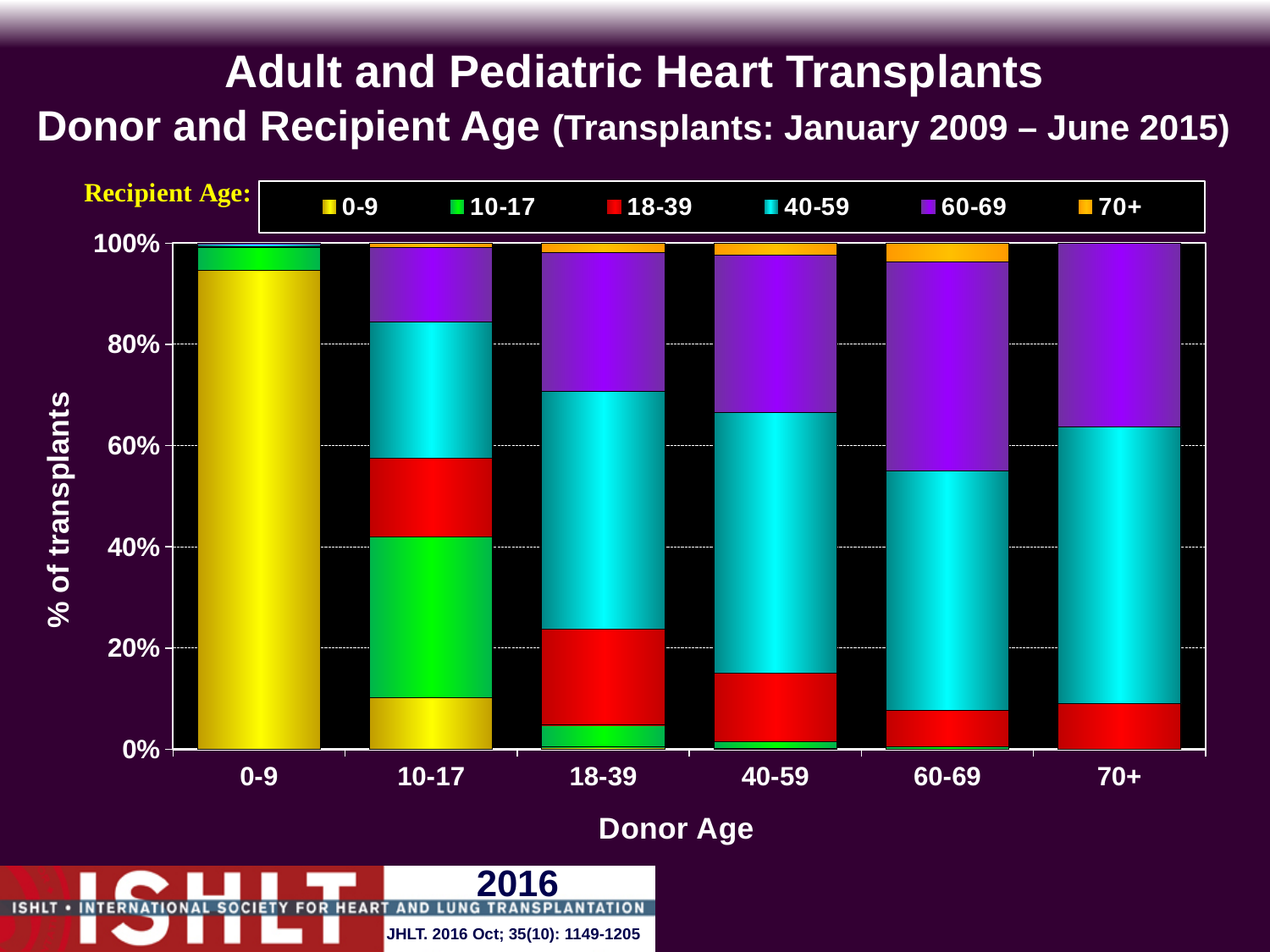
What kind of chart is shown on the slide? Stacked bar chart Does the share of 0-9 recipients rise or fall as donor age increases along the x axis? Falls For donor age 70+, which recipient age group has the larger share: 40-59 or 60-69? 40-59 How many recipient age groups does the legend list? 6 Which donor age group has the largest share of 10-17 recipients? 10-17 For donor age 0-9, is the share of 0-9 recipients greater or less than 80%? greater For donor age 70+, is the share of 18-39 recipients greater or less than 20%? less For donor age 60-69, is the share of 40-59 recipients greater or less than 40%? greater How many donor age categories are shown on the x axis? 6 What is the label of the x axis? Donor Age Which donor age group has the largest share of 0-9 recipients? 0-9 What is the total height of each stacked bar? 100%